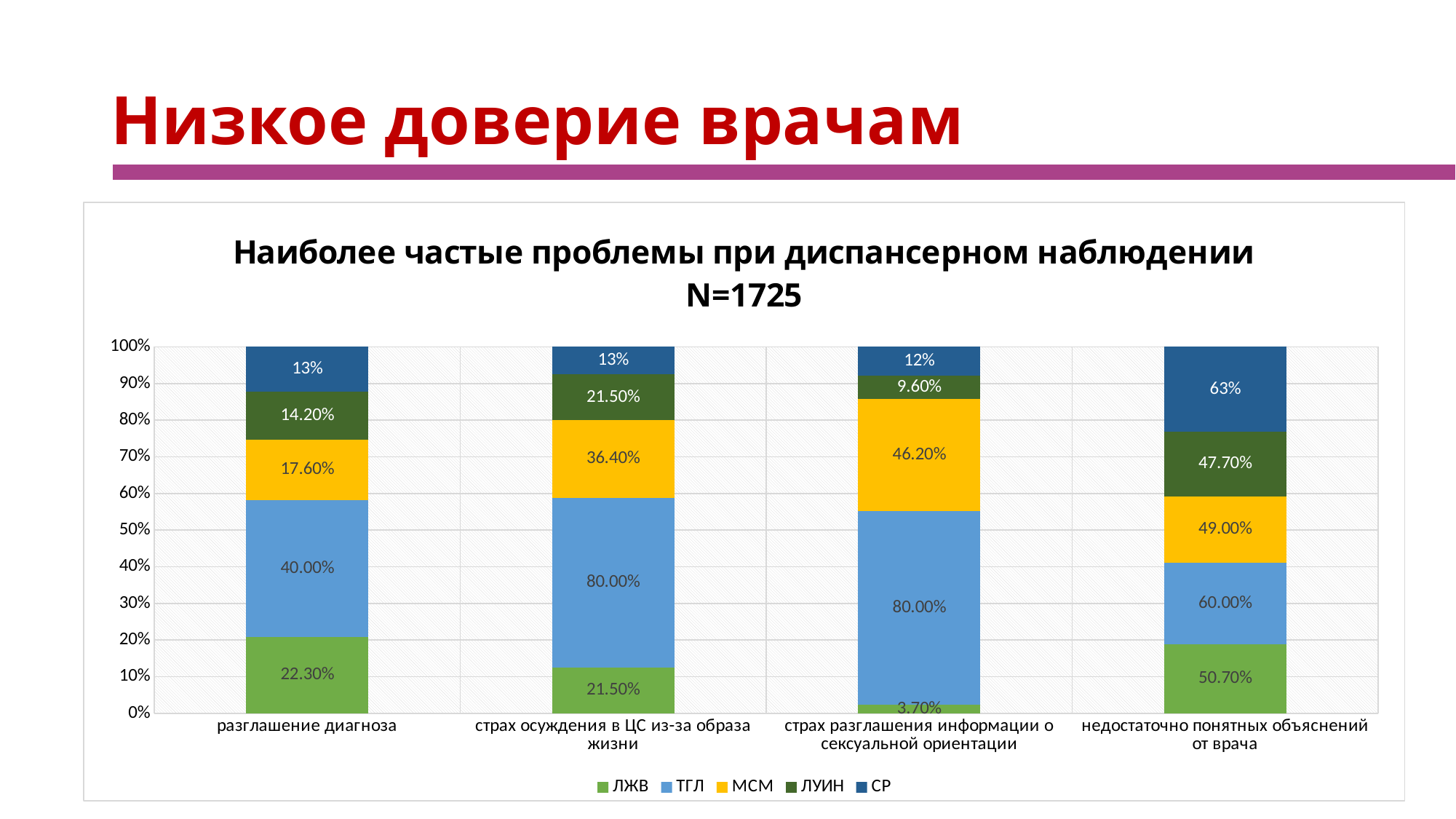
What is the difference between the ТГЛ values for 'страх осуждения в ЦС из-за образа жизни' and 'разглашение диагноза'? 40.00% What is the title of the chart? Наиболее частые проблемы при диспансерном наблюдении N=1725 What is the value for ЛУИН in the category 'страх осуждения в ЦС из-за образа жизни'? 21.50% What is the value for ЛЖВ in the category 'разглашение диагноза'? 22.30% What type of chart is shown on the slide? stacked bar chart What is the value for МСМ in the category 'страх разглашения информации о сексуальной ориентации'? 46.20% How many categories are shown on the x axis? 4 What is the value for СР in the category 'недостаточно понятных объяснений от врача'? 63% Which is larger: the МСМ value for 'разглашение диагноза' or the МСМ value for 'страх осуждения в ЦС из-за образа жизни'? страх осуждения в ЦС из-за образа жизни How many series does the legend list? 5 In which category is the value for ЛЖВ the lowest? страх разглашения информации о сексуальной ориентации In which category is the value for СР the highest? недостаточно понятных объяснений от врача